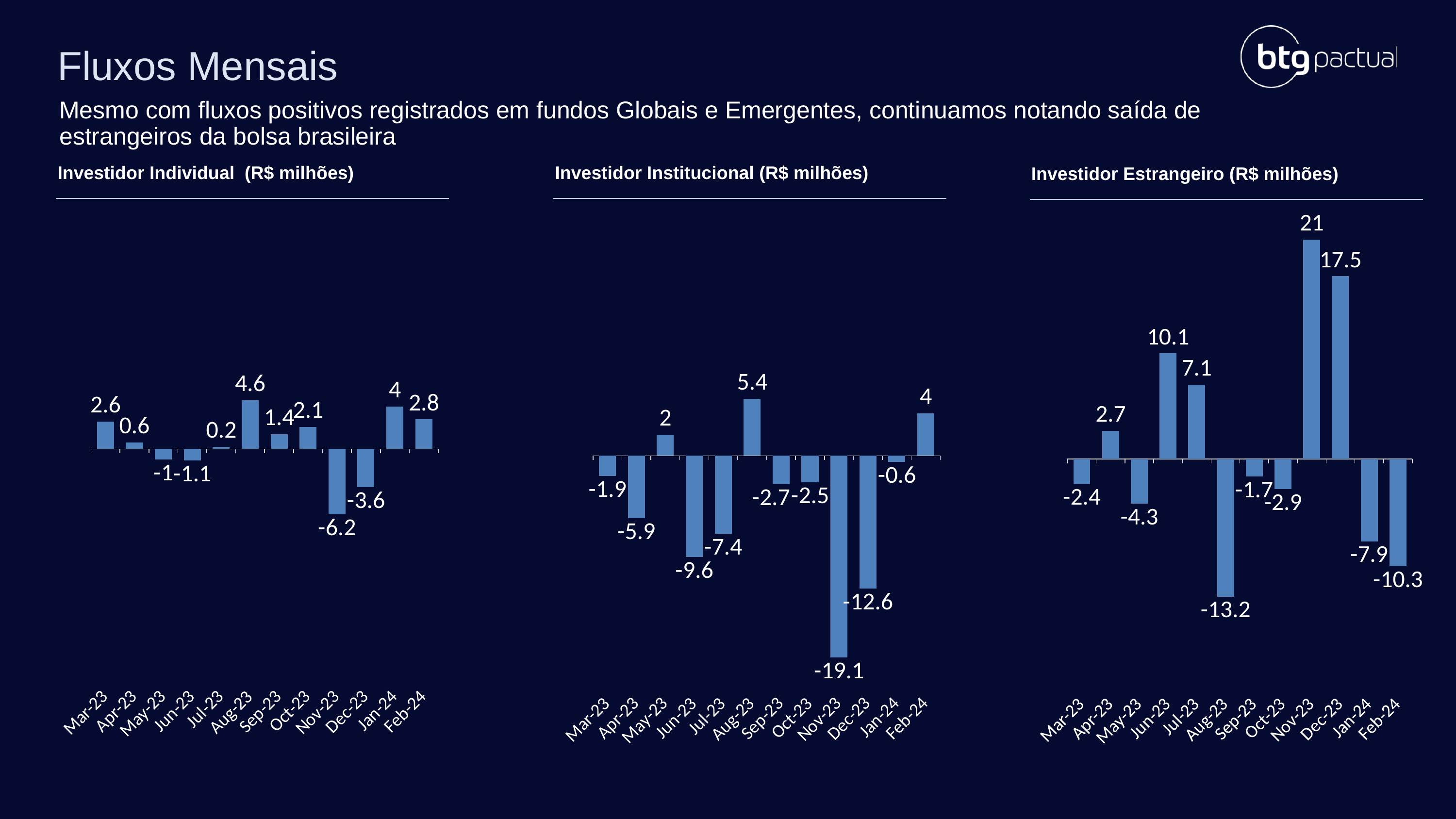
In the Investidor Institucional chart, what is the value for Nov-23? -19.1 What type of chart is the Investidor Estrangeiro chart? Bar chart In the Investidor Institucional chart, which is larger, the value for Jun-23 or the value for Jul-23? Jul-23 In the Investidor Individual chart, what is the value for Aug-23? 4.6 In the Investidor Individual chart, what is the difference between the Jan-24 and Feb-24 values? 1.2 In the Investidor Individual chart, which month has the lowest value? Nov-23 In the Investidor Estrangeiro chart, what is the value for Dec-23? 17.5 In the Investidor Estrangeiro chart, what is the difference between the Nov-23 and Dec-23 values? 3.5 How many months are shown in the Investidor Institucional chart? 12 In the Investidor Estrangeiro chart, which month has the highest value? Nov-23 In the Investidor Institucional chart, which month has the highest value? Aug-23 In the Investidor Estrangeiro chart, which month has the lowest value? Aug-23